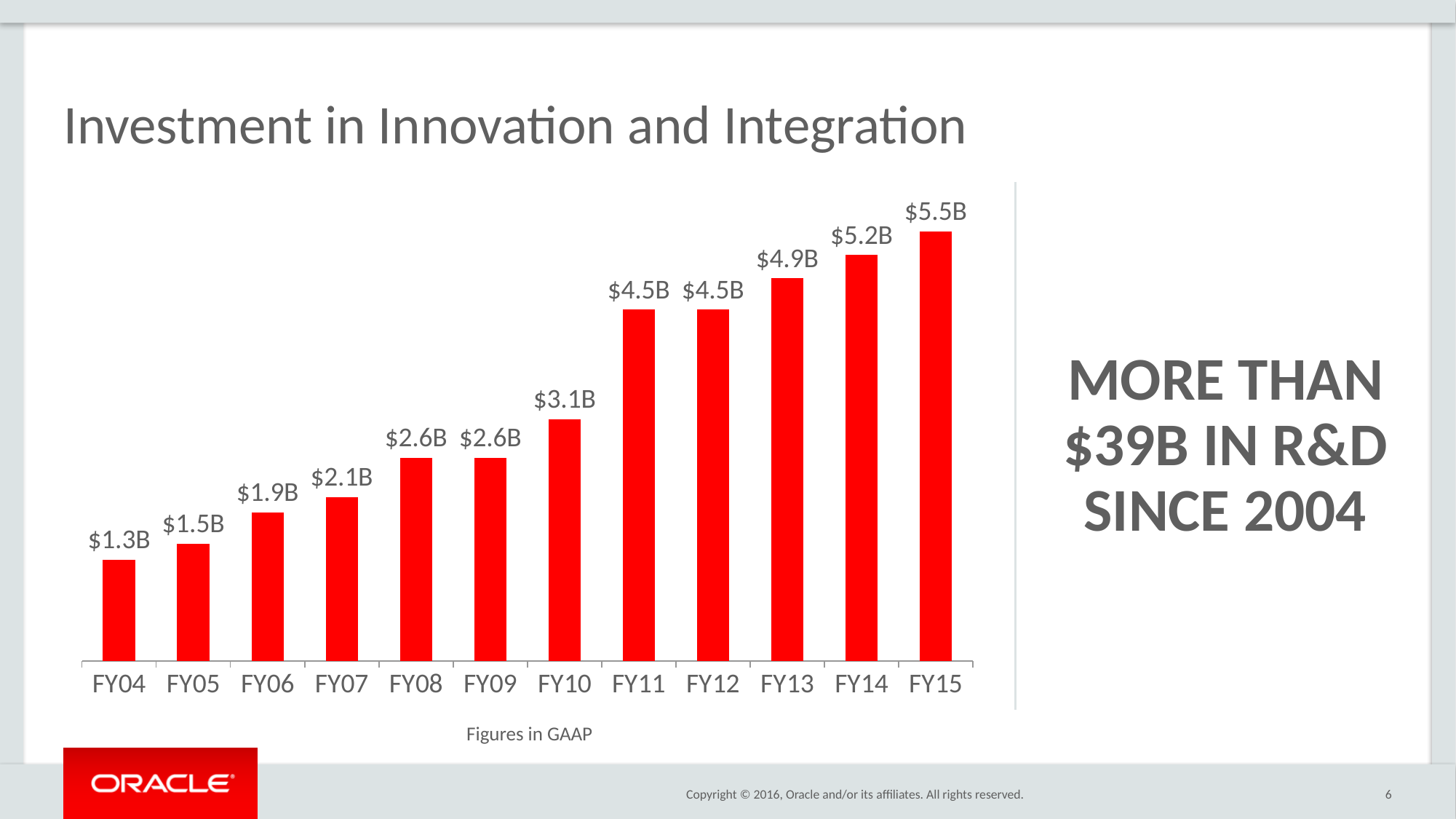
What is the value for FY10? $3.1B What note appears below the chart's x axis? Figures in GAAP How many fiscal years are shown on the chart? 12 What is the difference between the FY15 value and the FY04 value? $4.2B What is the difference between the FY11 value and the FY10 value? $1.4B Which fiscal year has the lowest value? FY04 Which fiscal year has the highest value? FY15 Which is larger, the value for FY07 or the value for FY09? FY09 What kind of chart is shown on the slide? Bar chart What is the value for FY13? $4.9B What is the value for FY04? $1.3B Do the values generally rise or fall from FY04 to FY15? Rise